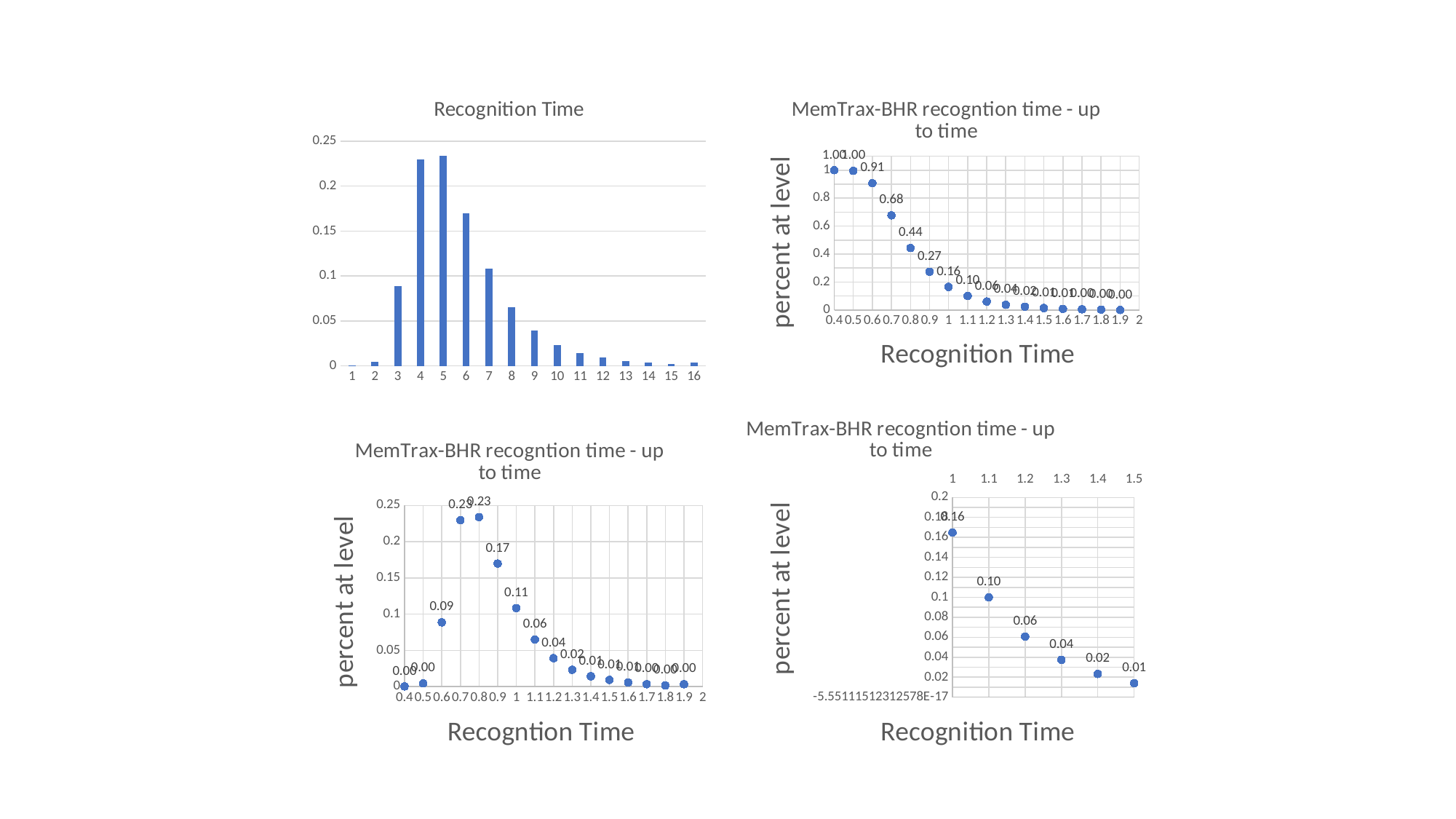
In the top-right chart, what is the value at recognition time 0.7? 0.68 In the top-right chart, what is the value at recognition time 0.9? 0.27 What kind of chart is the top-left chart titled "Recognition Time"? bar chart In the top-right chart, do the values rise or fall as recognition time increases? fall In the top-left "Recognition Time" bar chart, is the value for category 6 greater or less than 0.15? greater How many categories are shown on the x axis of the top-left "Recognition Time" bar chart? 16 In the top-left "Recognition Time" bar chart, which category has the highest bar? 5 In the bottom-left chart, what is the value at recognition time 0.9? 0.17 In the bottom-right chart, what is the value at recognition time 1.2? 0.06 In the top-left "Recognition Time" bar chart, is the value for category 3 greater or less than 0.1? less In the bottom-left chart, which is larger, the value at recognition time 0.6 or at 1? 1 In the top-right chart, what is the difference between the values at recognition time 0.6 and 0.8? 0.47